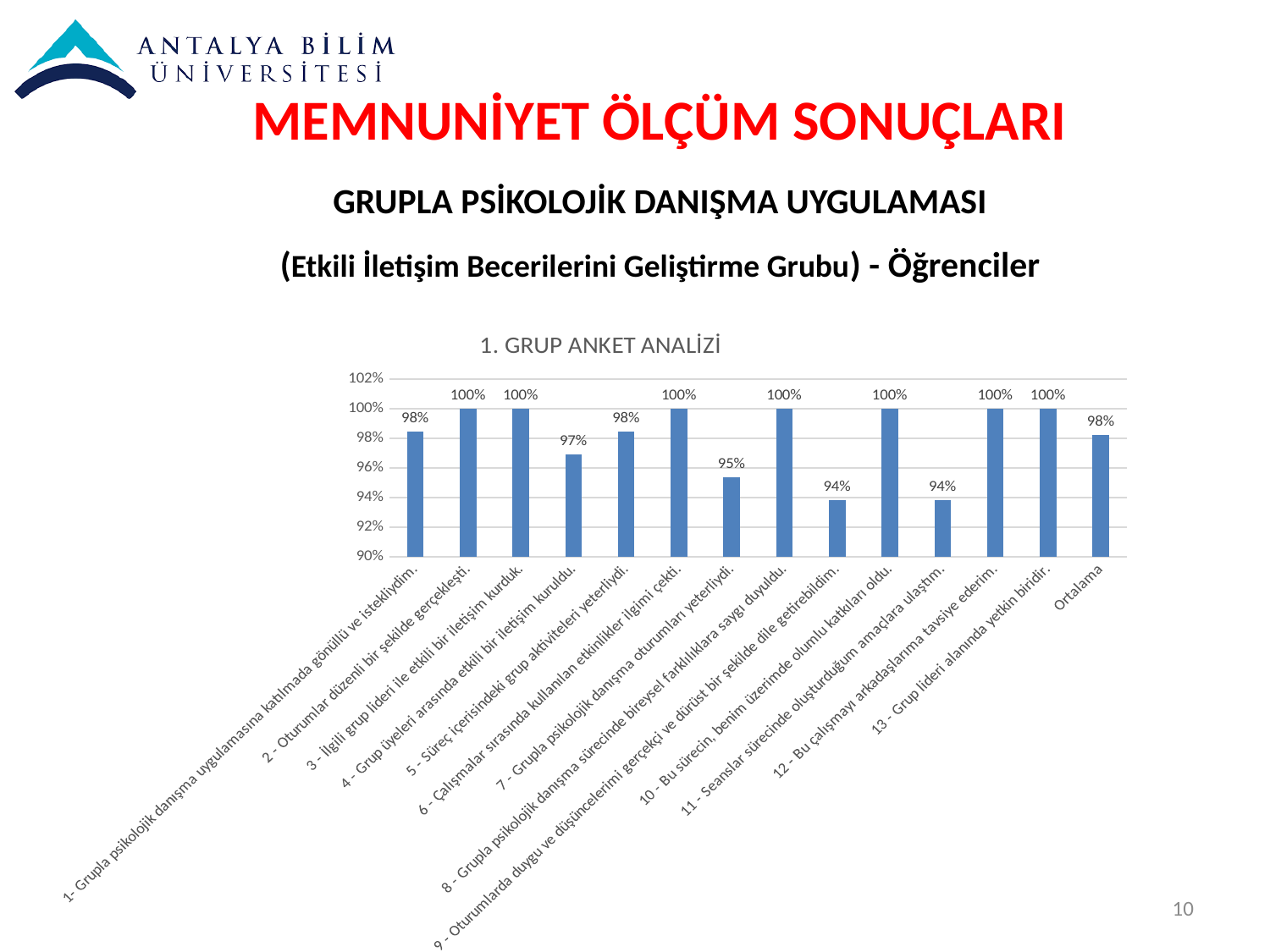
What is the value for item 4 (Grup üyeleri arasında etkili bir iletişim kuruldu)? 97% Is the value for item 11 (Seanslar sürecinde oluşturduğum amaçlara ulaştım) greater or less than 96%? less What is the value for item 2 (Oturumlar düzenli bir şekilde gerçekleşti)? 100% Which is larger, the value for item 4 or the value for item 7? item 4 What kind of chart is shown on the slide? bar chart What is the value for Ortalama? 98% What is the difference between the value for item 1 (98%) and the value for item 9 (94%)? 4% What is the value for item 9 (Oturumlarda duygu ve düşüncelerimi gerçekçi ve dürüst bir şekilde dile getirebildim)? 94% What is the title of the chart on the slide? 1. GRUP ANKET ANALİZİ How many bars in the chart reach 100%? 7 How many bars are plotted in the chart? 14 What is the value for item 7 (Grupla psikolojik danışma oturumları yeterliydi)? 95%